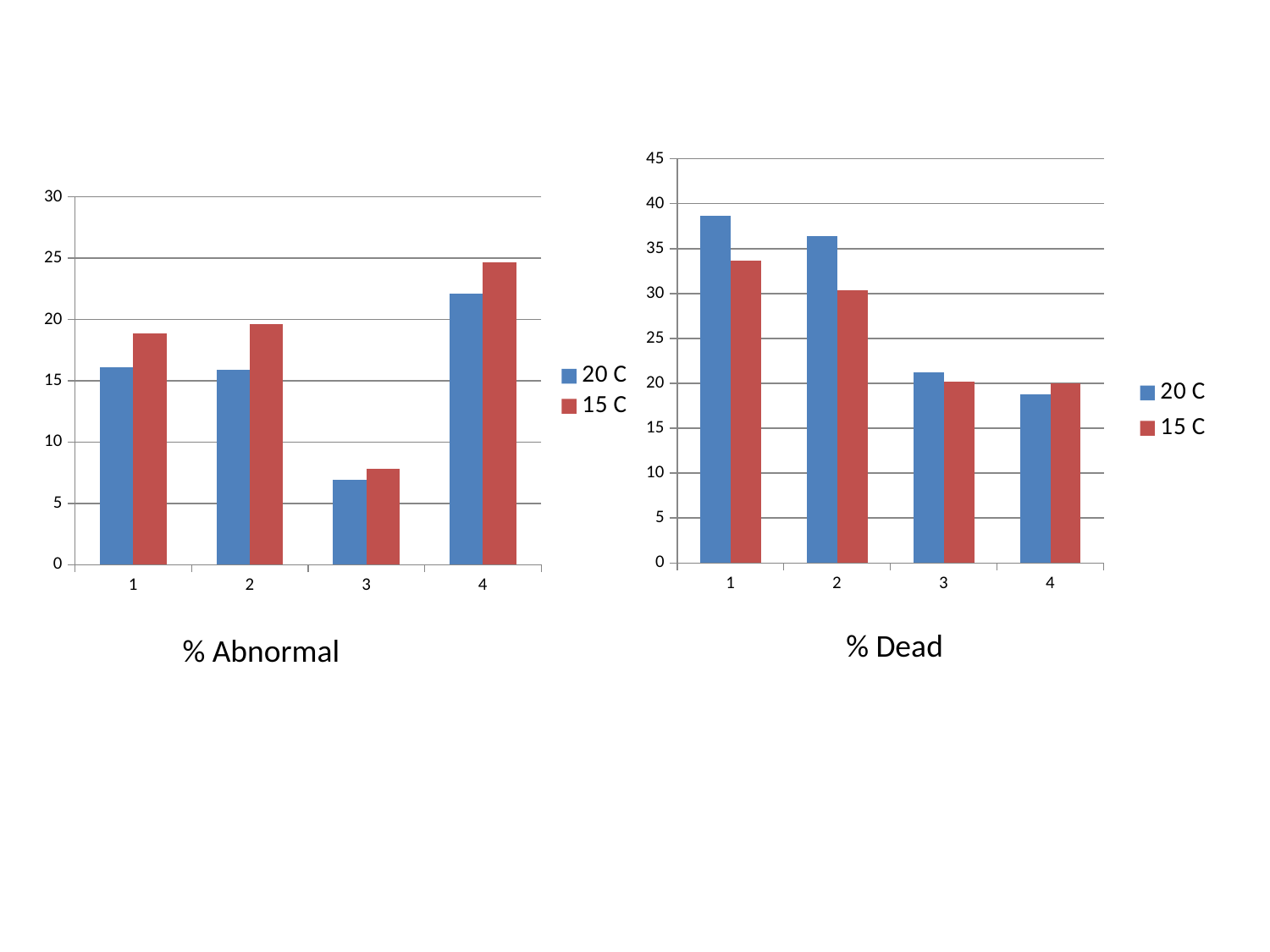
In the % Abnormal chart, which category has the highest 15 C value? 4 In the % Abnormal chart, which category has the lowest 20 C value? 3 In the % Abnormal chart, is the 15 C value for category 3 greater or less than 10? less In the % Dead chart, which category has the highest 20 C value? 1 In the % Dead chart, is the 20 C value for category 1 greater or less than 35? greater What kind of chart is the % Abnormal chart? bar chart What are the two legend entries in the % Abnormal chart? 20 C and 15 C In the % Abnormal chart, is the 20 C value for category 4 greater or less than 20? greater In the % Dead chart, which series has the larger value for category 2, 20 C or 15 C? 20 C How many categories are shown on the x axis of the % Abnormal chart? 4 How many series does the legend of the % Dead chart list? 2